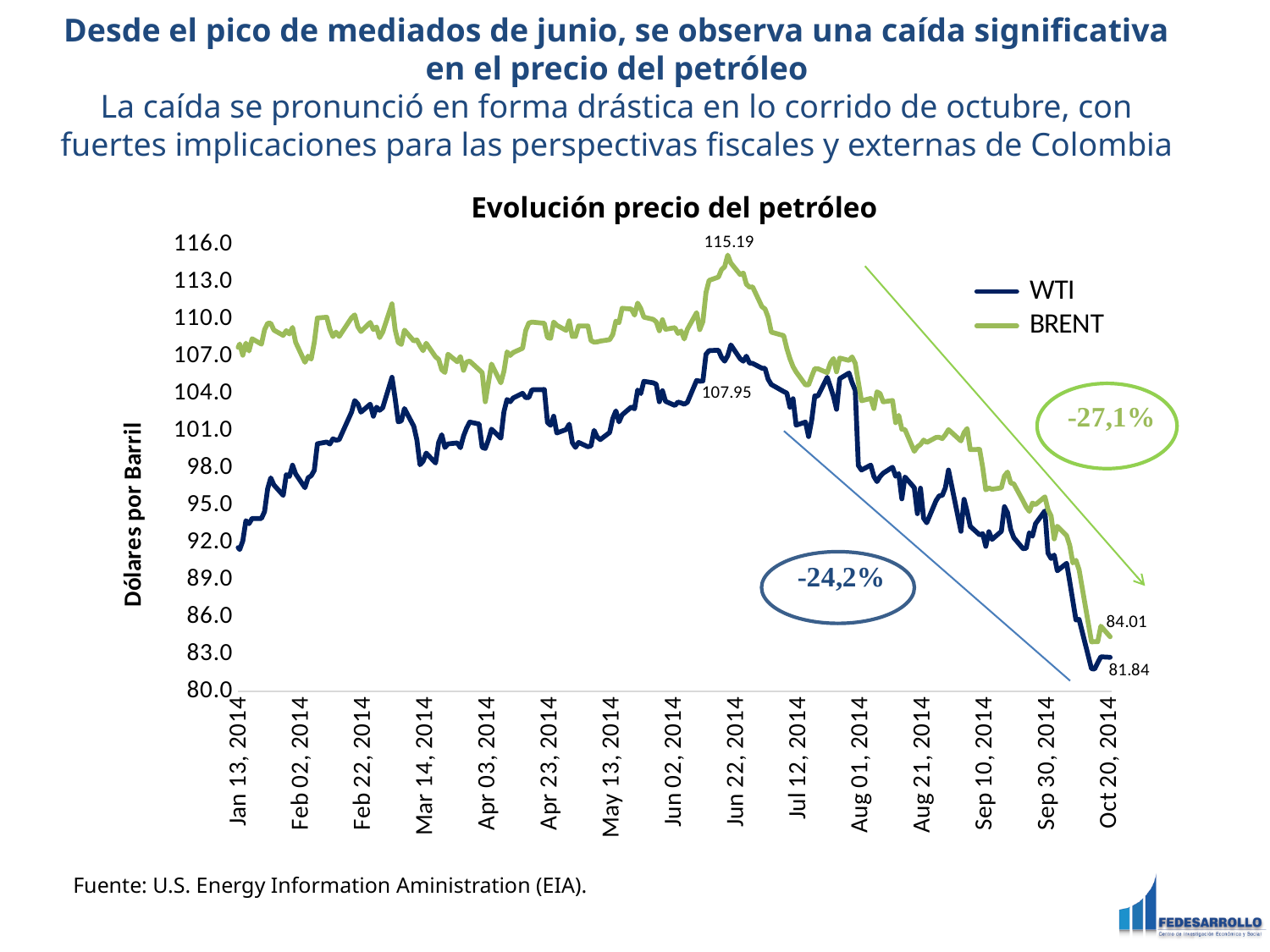
Which series reaches the higher peak, WTI or BRENT? BRENT How much did BRENT fall from its labelled peak of 115.19 to its labelled final value of 84.01? 31.18 What is the difference between the labelled BRENT peak (115.19) and the labelled WTI peak (107.95)? 7.24 What percentage decline is annotated for the WTI line? -24,2% What is the final value labelled for BRENT at the right end of the chart? 84.01 What is the peak value labelled on the WTI line? 107.95 What is the peak value labelled on the BRENT line? 115.19 What kind of chart is shown on the slide? Line chart How many series does the legend list? 2 From late June 2014 to October 20, 2014, do the oil prices rise or fall? Fall What is the final value labelled for WTI at the right end of the chart? 81.84 At the end of the series (Oct 20, 2014), which is higher, WTI or BRENT? BRENT